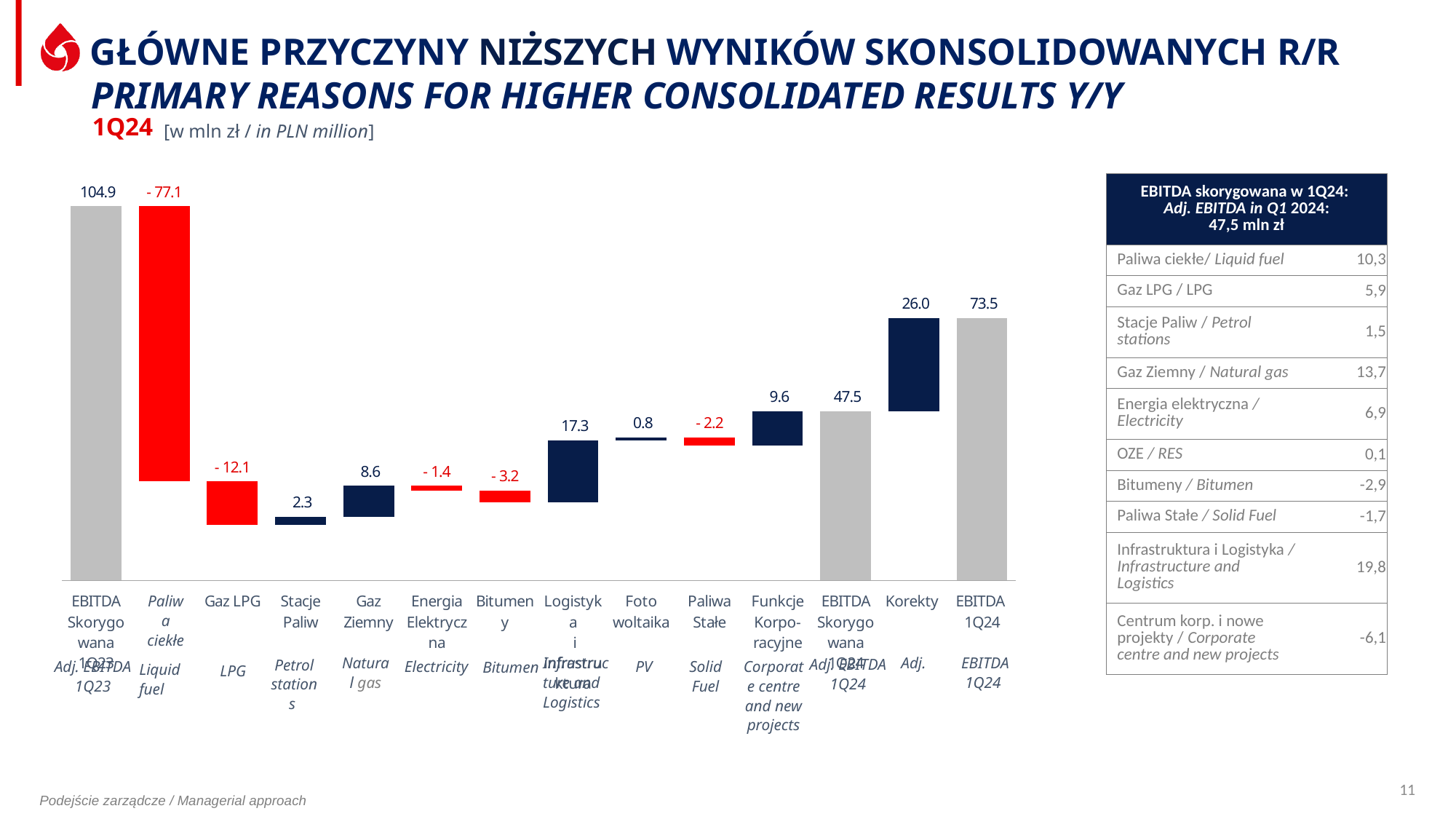
What kind of chart is shown on the slide? Waterfall bar chart Which is larger in the chart: the value for LPG or the value for Bitumen? Bitumen (- 3.2 is larger than - 12.1) Which bar in the chart has the highest value? Adj. EBITDA 1Q23 What is the difference between the Adj. EBITDA 1Q23 value (104.9) and the Adj. EBITDA 1Q24 value (47.5)? 57.4 What unit is stated for the values in the chart? PLN million (mln zł) What is the value shown for Natural gas (Gaz Ziemny) in the chart? 8.6 What is the value shown for the final EBITDA 1Q24 bar in the chart? 73.5 What is the value shown for Liquid fuel (Paliwa ciekłe) in the chart? - 77.1 What is the value shown for Adj. EBITDA 1Q23 in the chart? 104.9 Which bar in the chart has the largest negative value? Liquid fuel (Paliwa ciekłe) What is the value shown for Infrastructure and Logistics in the chart? 17.3 How many bars are plotted in the chart? 14